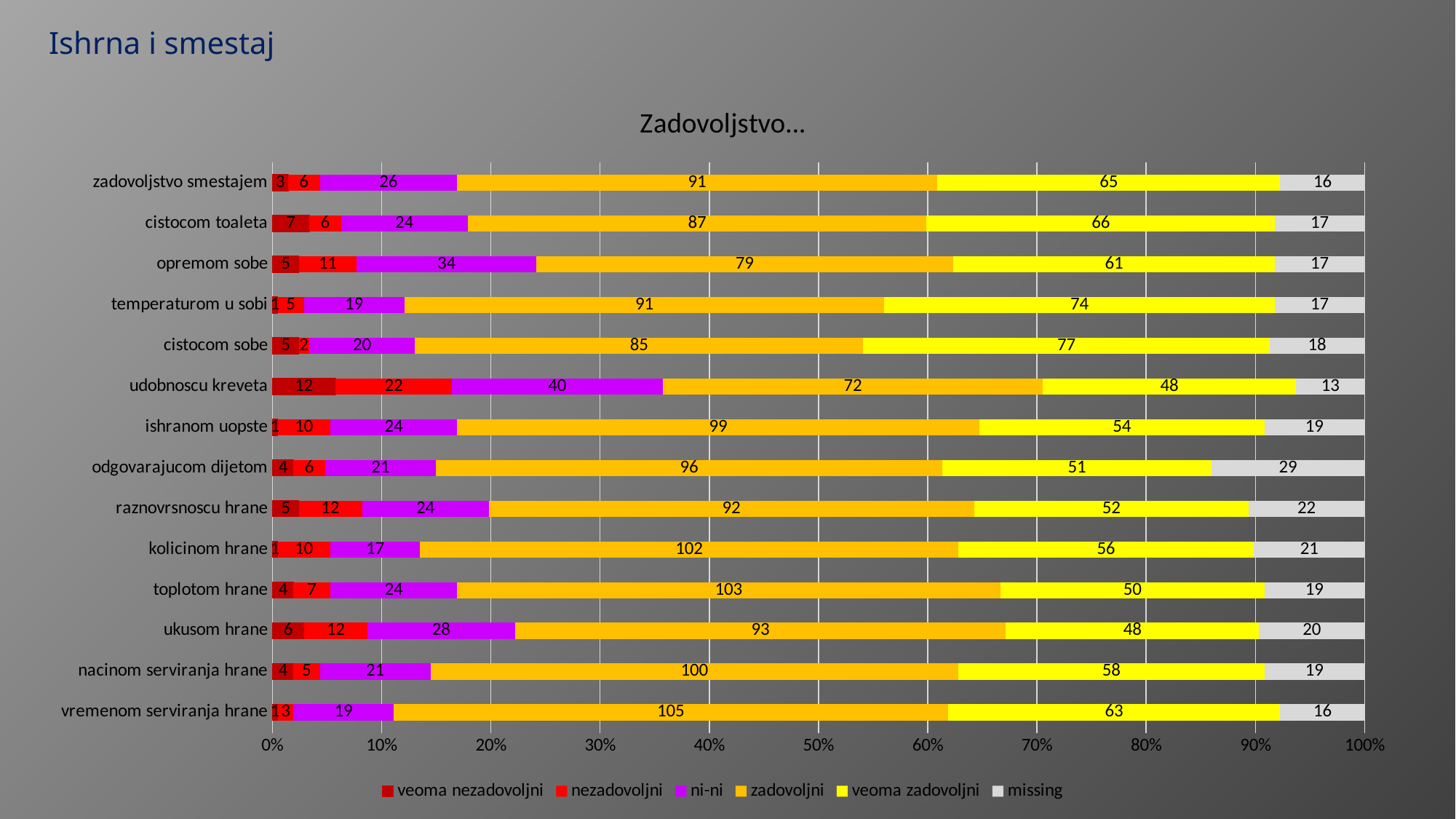
Which category has the highest value for the 'veoma zadovoljni' series? cistocom sobe What is the title of the chart? Zadovoljstvo... What is the value of the 'missing' series for 'odgovarajucom dijetom'? 29 Which category has the highest value for the 'veoma nezadovoljni' series? udobnoscu kreveta Which has a larger 'ni-ni' value: 'opremom sobe' or 'udobnoscu kreveta'? udobnoscu kreveta What is the difference between the 'veoma zadovoljni' values for 'cistocom sobe' and 'udobnoscu kreveta'? 29 What is the value of the 'zadovoljni' series for 'vremenom serviranja hrane'? 105 What is the value of the 'ni-ni' series for 'udobnoscu kreveta'? 40 What kind of chart is shown on the slide? stacked bar chart How many categories are shown on the chart? 14 How many series does the legend list? 6 Which category has the lowest value for the 'zadovoljni' series? udobnoscu kreveta